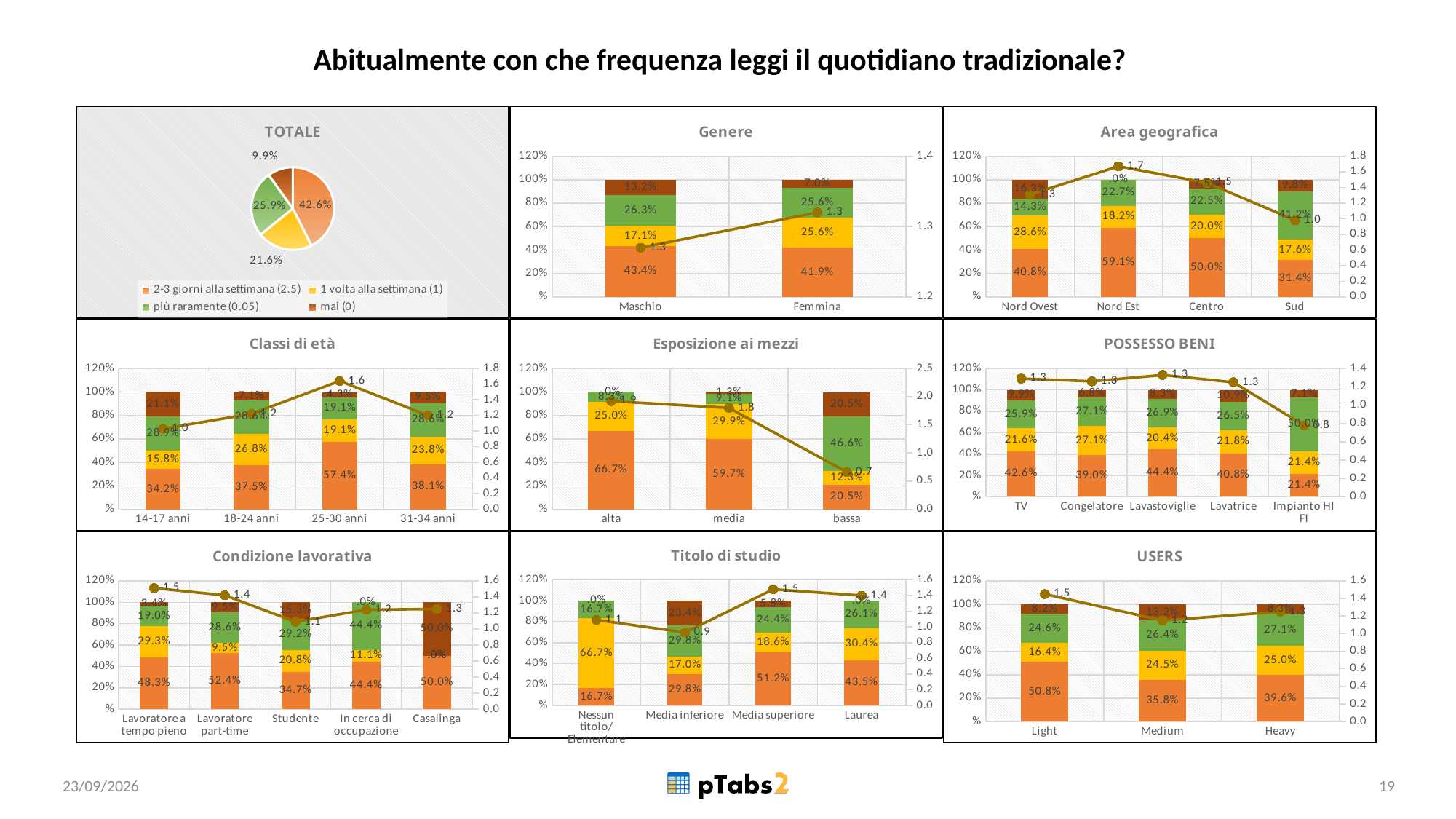
In the Esposizione ai mezzi chart, how many categories are shown on the x axis? 3 In the Esposizione ai mezzi chart, what is the line value for bassa? 0.7 In the Area geografica chart, what is the '2-3 giorni alla settimana' value for Sud? 31.4% In the Classi di età chart, what is the difference between the '2-3 giorni alla settimana' values for 25-30 anni and 14-17 anni? 23.2% In the POSSESSO BENI chart, what is the 'più raramente' value for Impianto HI FI? 50.0% In the TOTALE pie chart, what share is shown for '2-3 giorni alla settimana (2.5)'? 42.6% In the Titolo di studio chart, what is the '1 volta alla settimana' value for Nessun titolo/Elementare? 66.7% In the TOTALE pie chart, which category has the smallest slice? mai (0) In the Condizione lavorativa chart, which is larger: the '2-3 giorni alla settimana' value for Lavoratore part-time or for Studente? Lavoratore part-time In the Area geografica chart, which area has the highest line value? Nord Est In the Genere chart, what is the value of the '2-3 giorni alla settimana' segment for Maschio? 43.4% In the USERS chart, what kind of chart is used for the percentage values? Stacked bar chart